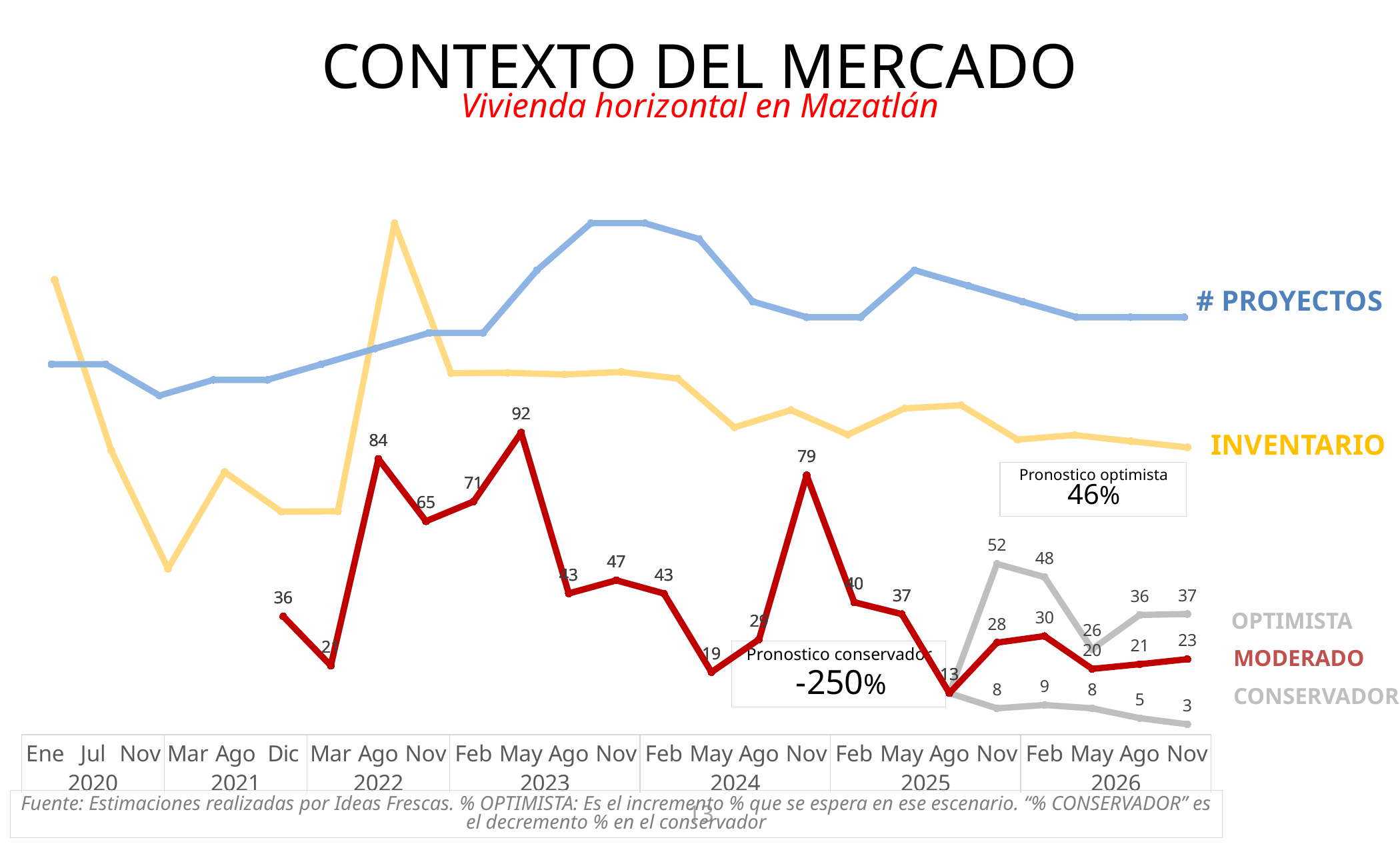
What is the highest labelled value on the OPTIMISTA line? 52 What is the lowest labelled value on the CONSERVADOR line? 3 How many labelled points does the OPTIMISTA line have? 5 What type of chart is shown on the slide? line chart What is the last labelled value on the OPTIMISTA line (Nov 2026)? 37 What percentage is shown in the 'Pronostico optimista' box? 46% What is the last labelled value on the MODERADO line (Nov 2026)? 23 Which is larger on the MODERADO line: the peak labelled 84 or the peak labelled 79? 84 What percentage is shown in the 'Pronostico conservador' box? -250% What is the difference between the two highest labelled values on the MODERADO line, 92 and 84? 8 What is the lowest labelled value on the MODERADO line? 13 What is the highest labelled value on the MODERADO line? 92